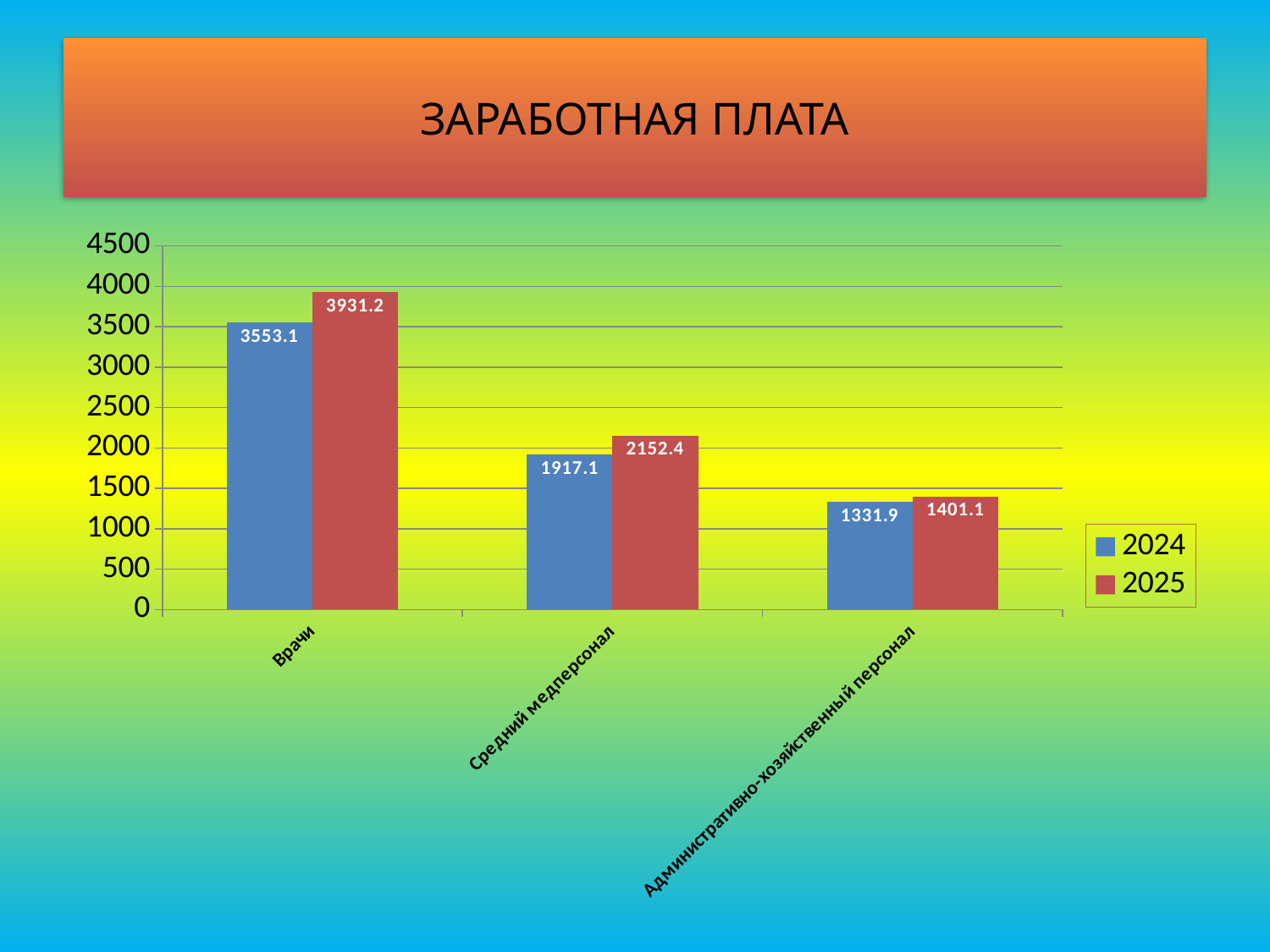
Is the 2024 value for Средний медперсонал greater or less than 2000? less How many categories are shown on the x axis? 3 Which category has the highest 2025 value? Врачи Which category has the lowest 2024 value? Административно-хозяйственный персонал What is the 2025 value for Средний медперсонал? 2152.4 What is the 2025 value for Административно-хозяйственный персонал? 1401.1 What kind of chart is shown on the slide? bar chart What is the 2024 value for Врачи? 3553.1 What is the difference between the 2025 and 2024 values for Врачи? 378.1 How many series does the legend list? 2 What is the difference between the 2025 and 2024 values for Средний медперсонал? 235.3 Which is larger for Административно-хозяйственный персонал: the 2024 value or the 2025 value? 2025